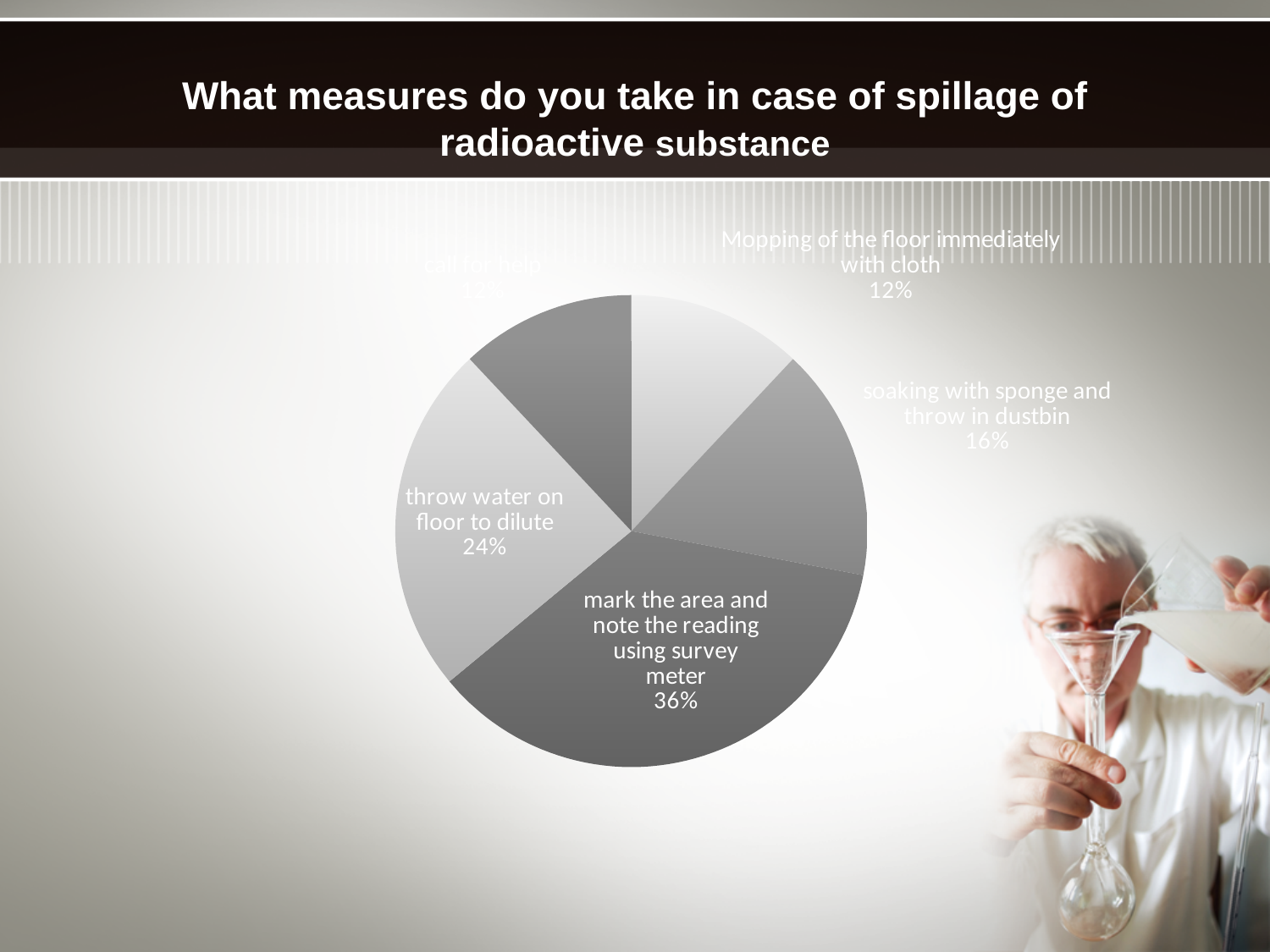
How many slices does the pie chart have? 5 What share of the pie is 'call for help'? 12% What is the title of the slide containing the pie chart? What measures do you take in case of spillage of radioactive substance What is the difference in percentage points between 'mark the area and note the reading using survey meter' and 'throw water on floor to dilute'? 12 Which is larger: the share for 'soaking with sponge and throw in dustbin' or the share for 'throw water on floor to dilute'? throw water on floor to dilute What share of the pie is 'throw water on floor to dilute'? 24% What share of the pie is 'Mopping of the floor immediately with cloth'? 12% Which measure has the largest share of the pie? mark the area and note the reading using survey meter What is the difference in percentage points between 'soaking with sponge and throw in dustbin' and 'call for help'? 4 What kind of chart is shown on the slide? pie chart